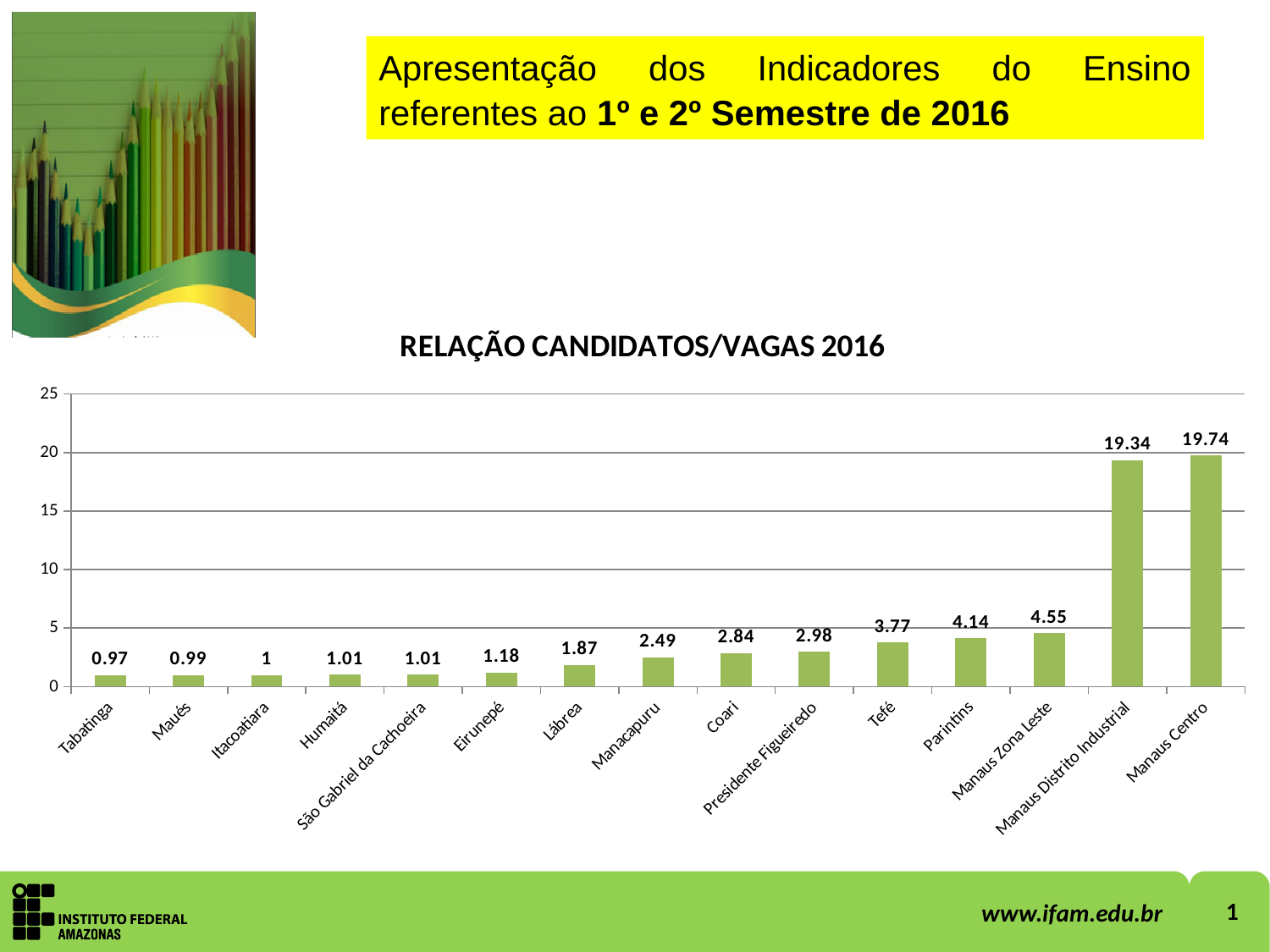
Is the value for Manaus Distrito Industrial greater or less than 15? greater Which is larger, the value for Coari or the value for Presidente Figueiredo? Presidente Figueiredo What is the difference between the values for Manaus Centro and Manaus Distrito Industrial? 0.4 What is the value for Manaus Centro? 19.74 What is the value for Tefé? 3.77 What is the title of the chart? RELAÇÃO CANDIDATOS/VAGAS 2016 What kind of chart is shown on the slide? Bar chart What is the value for Lábrea? 1.87 Which campus has the highest candidates/vacancies ratio? Manaus Centro Which campus has the lowest candidates/vacancies ratio? Tabatinga What is the difference between the values for Manaus Zona Leste and Parintins? 0.41 How many campuses are shown on the x axis? 15